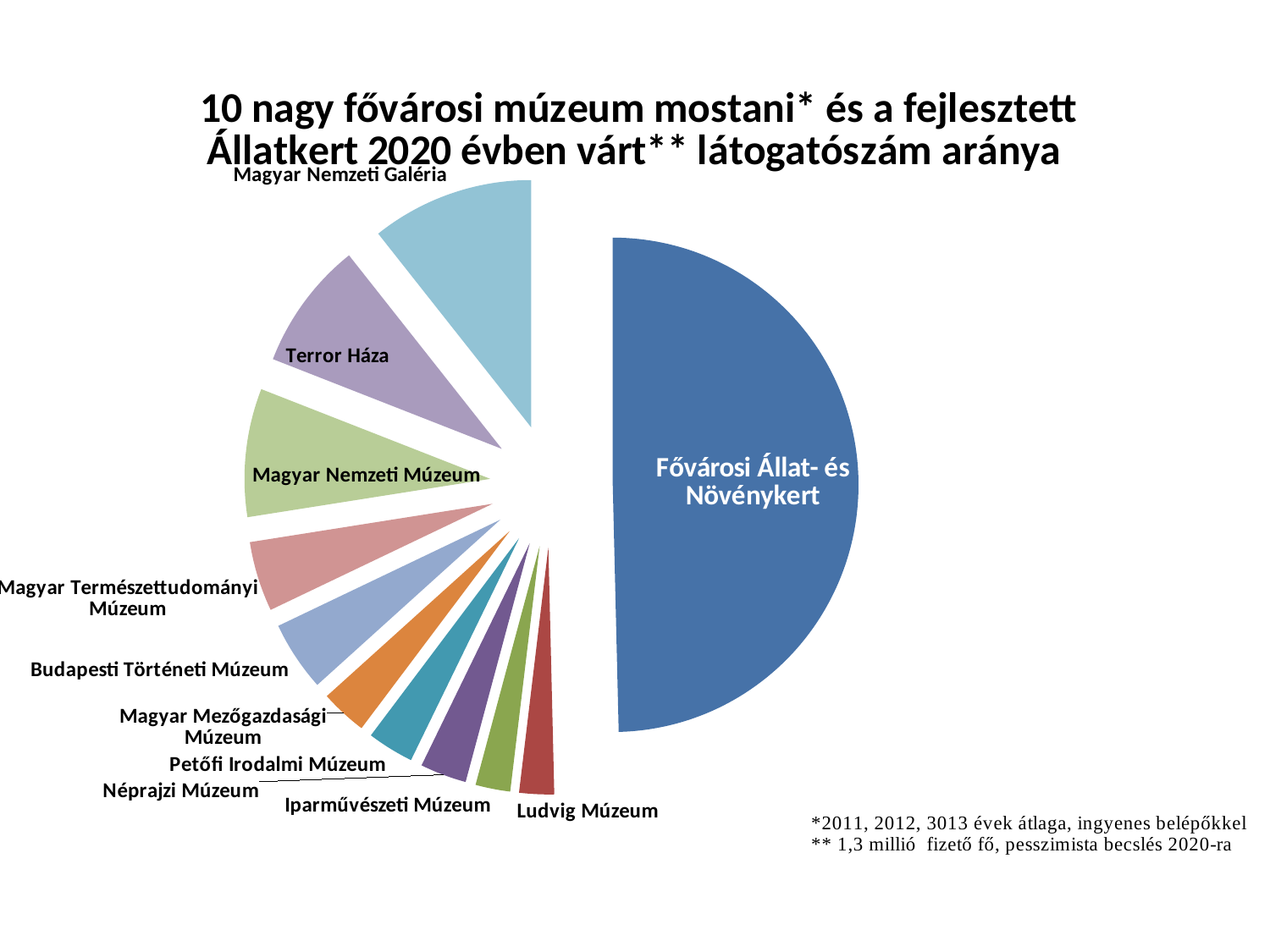
Which category has the largest slice in the pie chart? Fővárosi Állat- és Növénykert Which slice is larger: Magyar Nemzeti Galéria or Ludvig Múzeum? Magyar Nemzeti Galéria What is the title of the chart? 10 nagy fővárosi múzeum mostani* és a fejlesztett Állatkert 2020 évben várt** látogatószám aránya Which slice is larger: Magyar Nemzeti Múzeum or Néprajzi Múzeum? Magyar Nemzeti Múzeum What kind of chart is shown on the slide? pie chart Which slice is larger: Magyar Természettudományi Múzeum or Magyar Mezőgazdasági Múzeum? Magyar Természettudományi Múzeum How many slices does the pie chart have? 11 What colour is the Fővárosi Állat- és Növénykert slice? blue